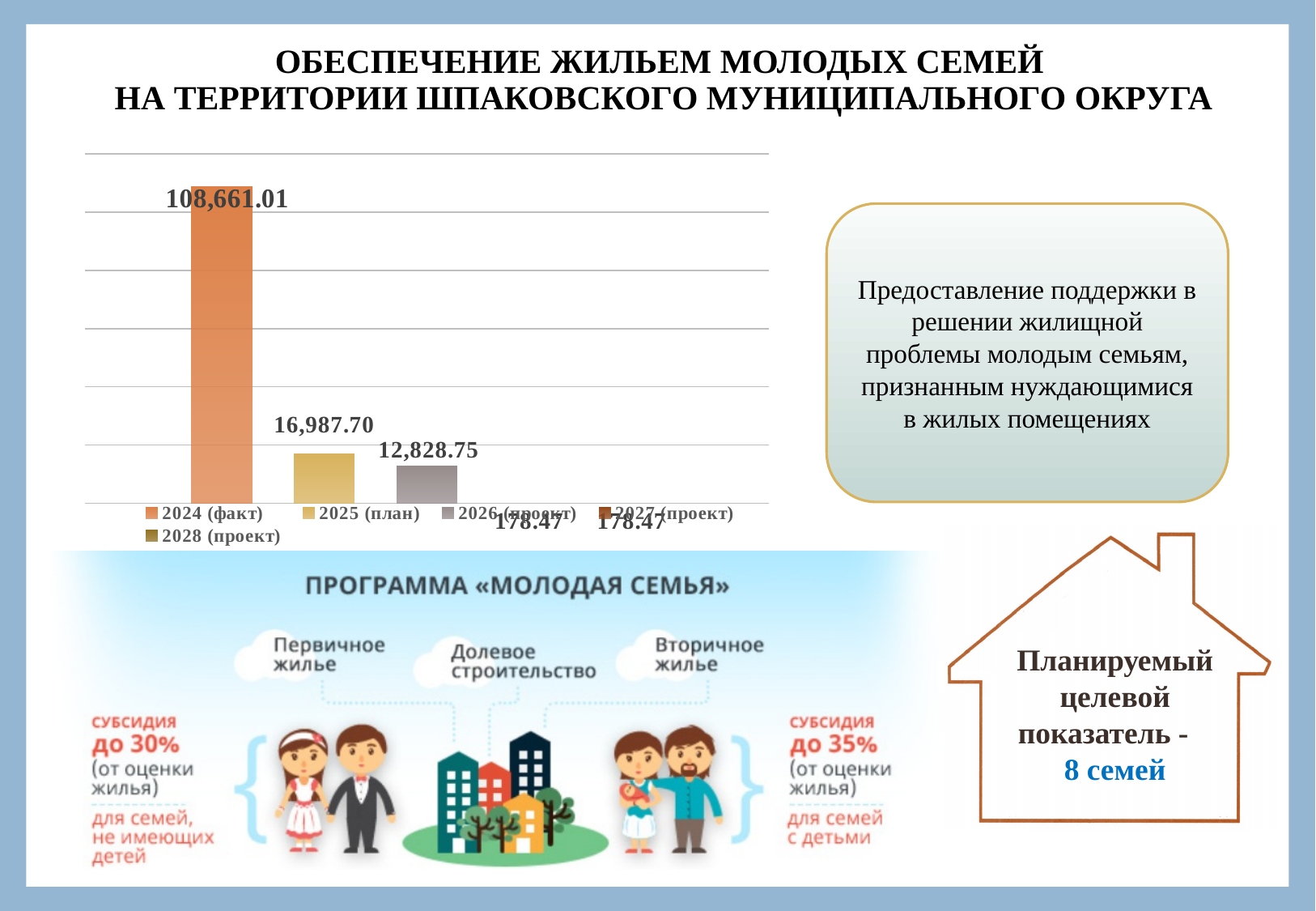
What is the value shown for 2025 (план) in the bar chart? 16,987.70 What is the value shown for 2024 (факт) in the bar chart? 108,661.01 What is the difference between the values for 2024 (факт) and 2025 (план)? 91,673.31 Which series has the highest value in the bar chart? 2024 (факт) Do the values in the bar chart rise or fall from 2024 to 2028? Fall What is the value shown for 2028 (проект) in the bar chart? 178.47 How many series does the legend of the bar chart list? 5 What is the value shown for 2026 (проект) in the bar chart? 12,828.75 What is the difference between the values for 2025 (план) and 2026 (проект)? 4,158.95 What is the value shown for 2027 (проект) in the bar chart? 178.47 Which is larger, the value for 2025 (план) or the value for 2026 (проект)? 2025 (план) What kind of chart is shown on the slide? Bar chart